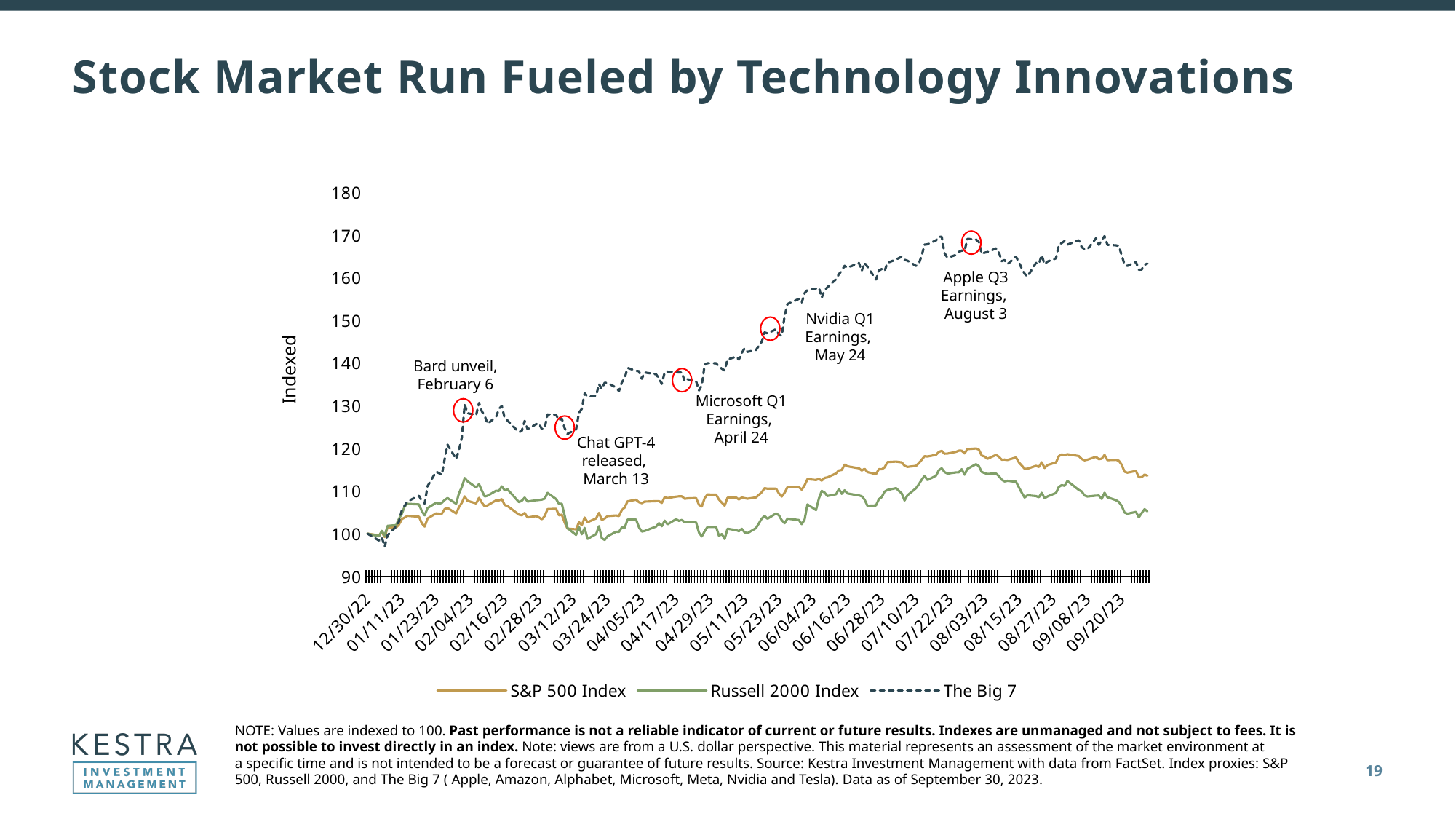
How many series does the legend list? 3 What is the title of the slide's chart? Stock Market Run Fueled by Technology Innovations Does The Big 7 series generally rise or fall from 12/30/22 to 09/20/23? Rise Is the value of the S&P 500 Index at the end of the period greater or less than 120? less Which series has the highest value at the end of the period (09/20/23)? The Big 7 Which series is drawn as a dashed line? The Big 7 Is the value of The Big 7 at the Apple Q3 Earnings (August 3) annotation greater or less than 160? greater What is the label on the vertical axis? Indexed Is the value of The Big 7 at the Chat GPT-4 released (March 13) annotation greater or less than 130? less Which series has the lowest value at the end of the period (09/20/23)? Russell 2000 Index Which is larger at the end of the period: the S&P 500 Index or the Russell 2000 Index? S&P 500 Index What kind of chart is shown on the slide? Line chart